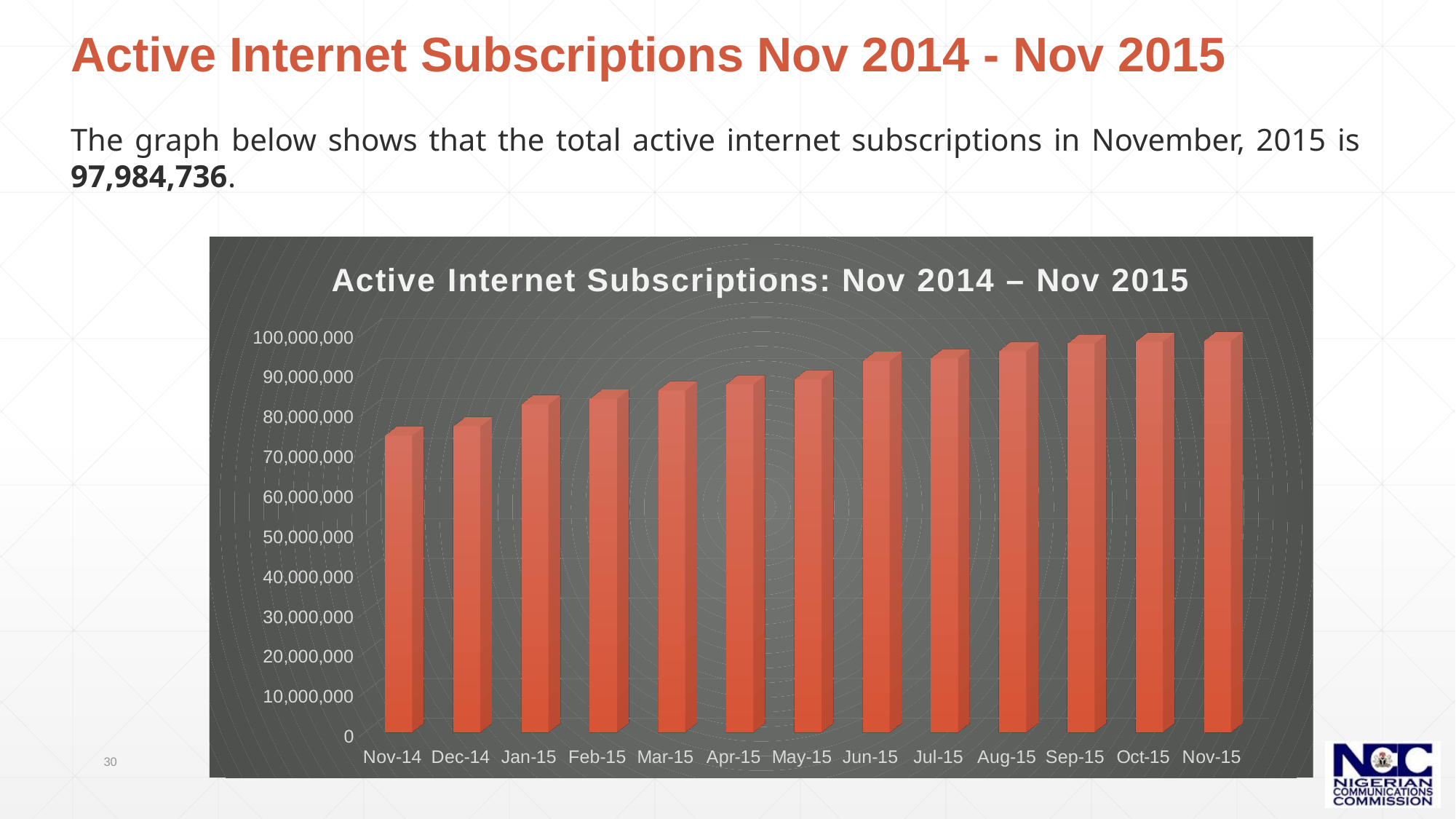
Is the value for Oct-15 greater or less than 100,000,000? less Is the value for Jun-15 greater or less than 90,000,000? greater Do active internet subscriptions generally rise or fall from Nov-14 to Nov-15? rise Is the value for Apr-15 greater or less than 90,000,000? less Which month has the lowest active internet subscriptions? Nov-14 According to the slide, what is the total active internet subscriptions in November 2015? 97,984,736 What is the title of the chart? Active Internet Subscriptions: Nov 2014 – Nov 2015 How many months are plotted on the chart? 13 Which is larger, the value for Jun-15 or the value for Feb-15? Jun-15 What kind of chart is shown on the slide? bar chart